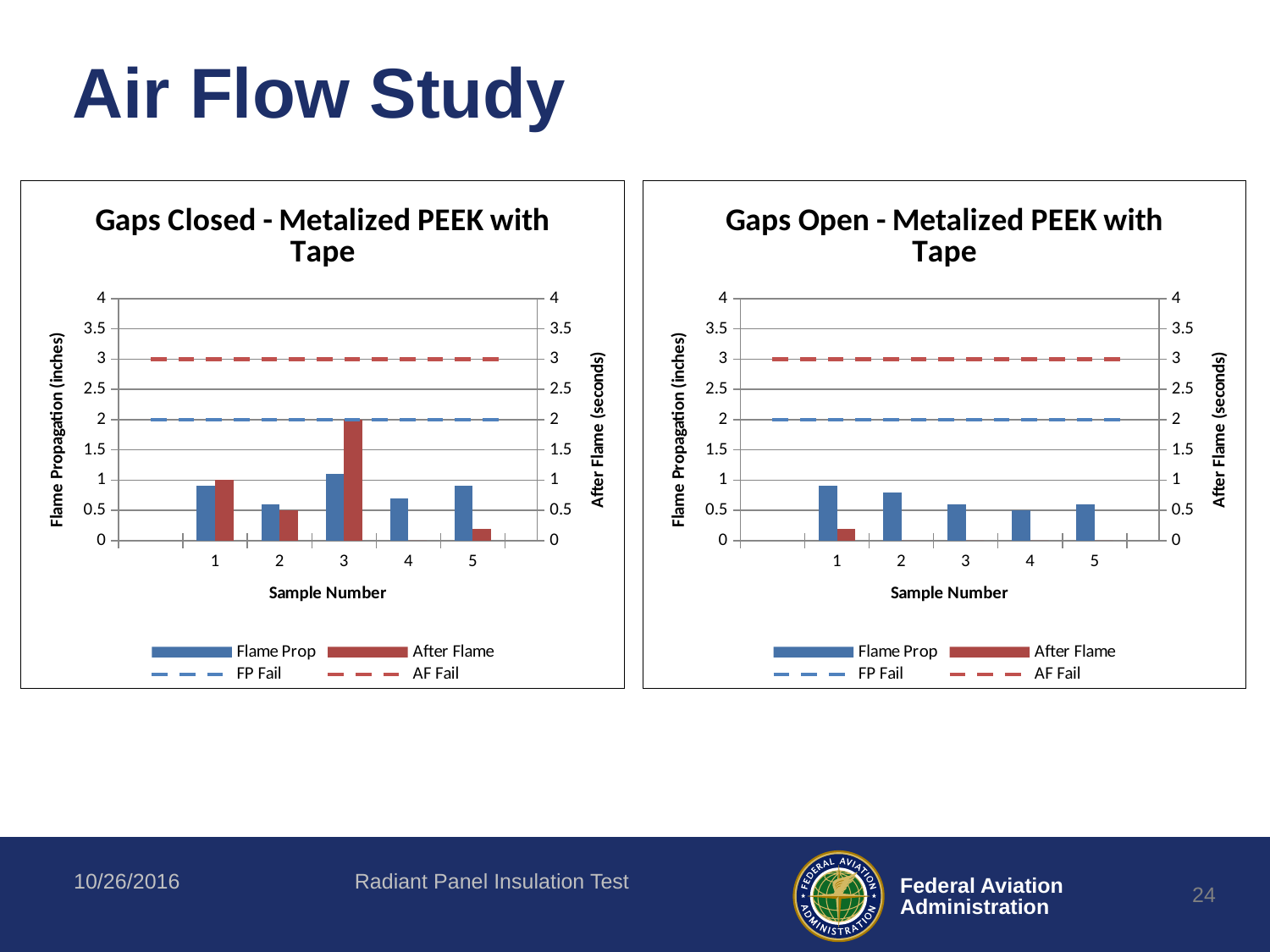
In the Gaps Closed - Metalized PEEK with Tape chart, which sample number has the highest After Flame value? 3 In the Gaps Closed - Metalized PEEK with Tape chart, which is larger for sample 3, Flame Prop or After Flame? After Flame How many sample numbers are shown on the x axis of the Gaps Open - Metalized PEEK with Tape chart? 5 What kind of chart is the Gaps Open - Metalized PEEK with Tape chart? Bar chart In the Gaps Closed - Metalized PEEK with Tape chart, at what level is the FP Fail dashed line drawn? 2 In the Gaps Closed - Metalized PEEK with Tape chart, what is the After Flame value for sample 3? 2 In the Gaps Open - Metalized PEEK with Tape chart, at what level is the AF Fail dashed line drawn? 3 In the Gaps Open - Metalized PEEK with Tape chart, is the Flame Prop value for sample 1 greater or less than 2? less In the Gaps Open - Metalized PEEK with Tape chart, which sample number is the only one with a visible After Flame bar? 1 How many entries does the legend of the Gaps Closed - Metalized PEEK with Tape chart list? 4 In the Gaps Closed - Metalized PEEK with Tape chart, which is larger, the Flame Prop value for sample 1 or for sample 2? Sample 1 In the Gaps Closed - Metalized PEEK with Tape chart, is the After Flame value for sample 3 greater or less than 1.5? greater